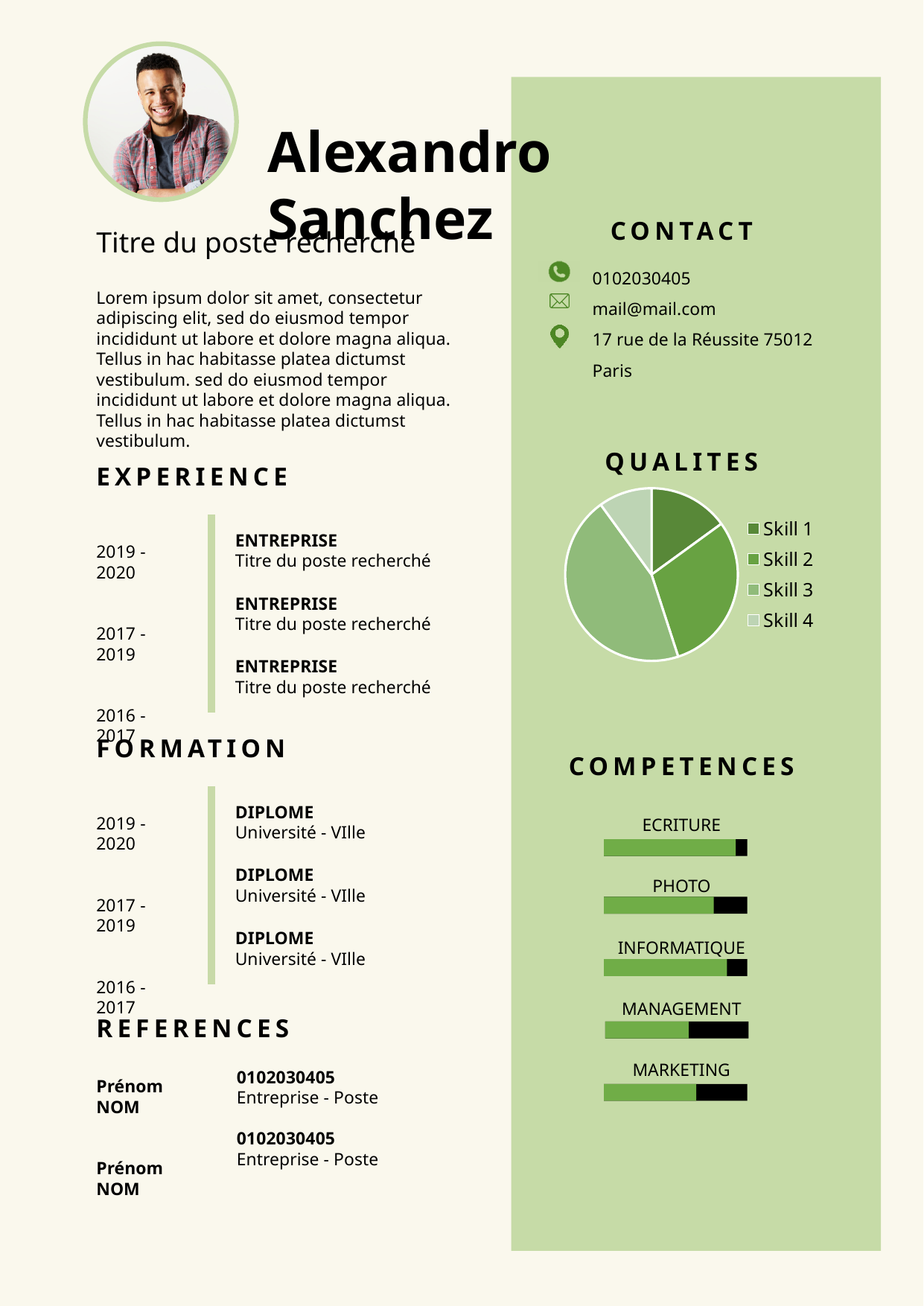
How many slices does the QUALITES pie chart have? 4 What are the legend entries of the QUALITES pie chart? Skill 1, Skill 2, Skill 3, Skill 4 What kind of chart is shown under the QUALITES heading? pie chart How many entries does the legend of the QUALITES pie chart list? 4 Which skill has the largest slice in the QUALITES pie chart? Skill 3 In the QUALITES pie chart, which slice is larger, Skill 2 or Skill 4? Skill 2 In the QUALITES pie chart, which slice is larger, Skill 2 or Skill 1? Skill 2 In the QUALITES pie chart, which slice is larger, Skill 3 or Skill 2? Skill 3 What heading appears above the pie chart? QUALITES